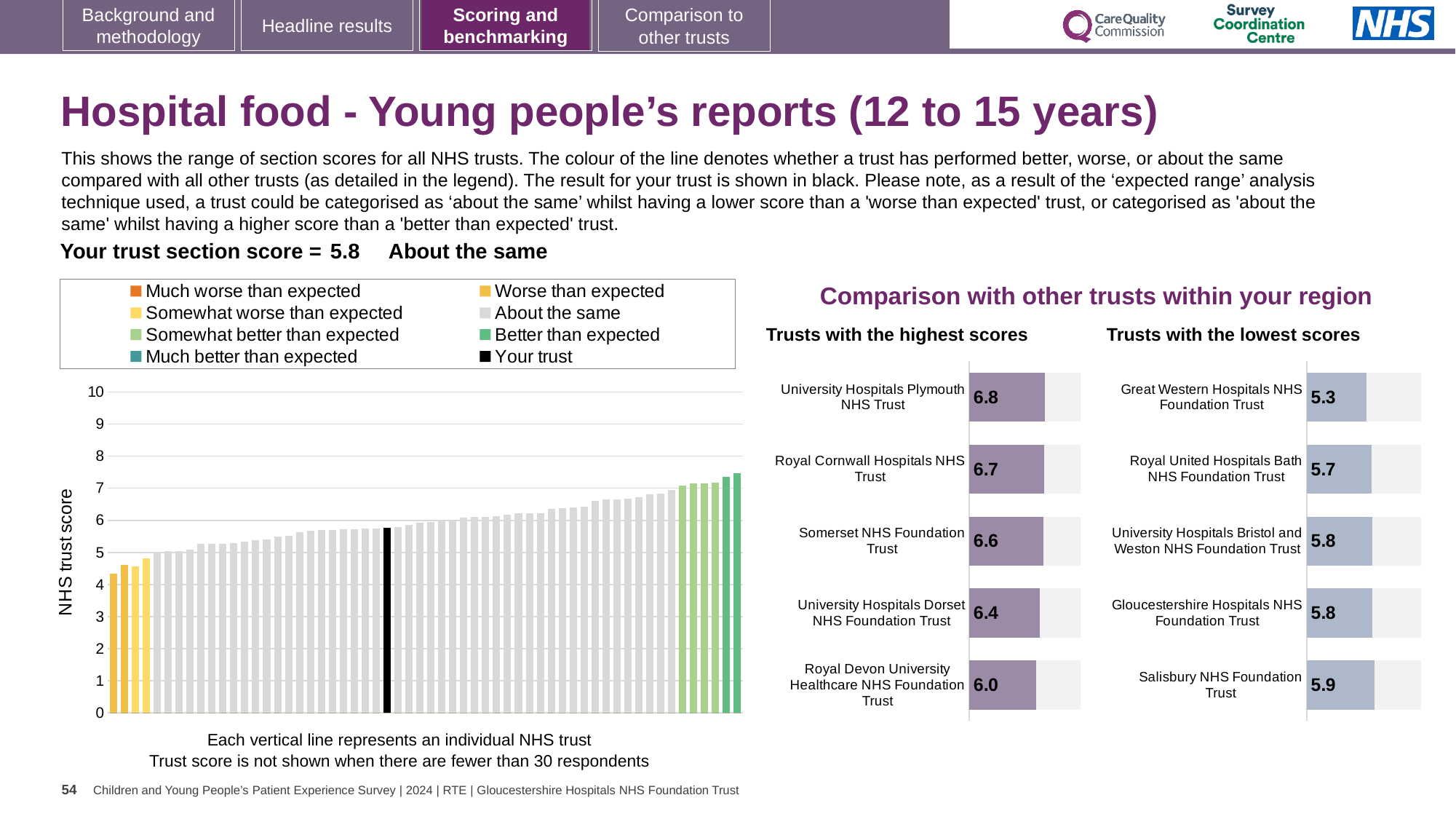
In the 'Trusts with the highest scores' chart, what is the score for Royal Devon University Healthcare NHS Foundation Trust? 6.0 In the 'Trusts with the highest scores' chart, which trust has the lowest score? Royal Devon University Healthcare NHS Foundation Trust In the 'Trusts with the lowest scores' chart, which has the larger score: Royal United Hospitals Bath NHS Foundation Trust or Salisbury NHS Foundation Trust? Salisbury NHS Foundation Trust In the main 'NHS trust score' chart on the left, do the bar values rise or fall from left to right? rise In the 'Trusts with the lowest scores' chart, what is the score for Great Western Hospitals NHS Foundation Trust? 5.3 How many trusts are shown in the 'Trusts with the lowest scores' chart? 5 In the 'Trusts with the highest scores' chart, what is the difference between the scores of University Hospitals Plymouth NHS Trust and Somerset NHS Foundation Trust? 0.2 How many entries does the legend above the main 'NHS trust score' chart list? 8 In the 'Trusts with the highest scores' chart, what is the score for University Hospitals Plymouth NHS Trust? 6.8 In the 'Trusts with the lowest scores' chart, which trust has the highest score? Salisbury NHS Foundation Trust In the main 'NHS trust score' chart on the left, is the value of the leftmost bar greater or less than 5? less In the main 'NHS trust score' chart on the left, is the value of the rightmost bar greater or less than 7? greater